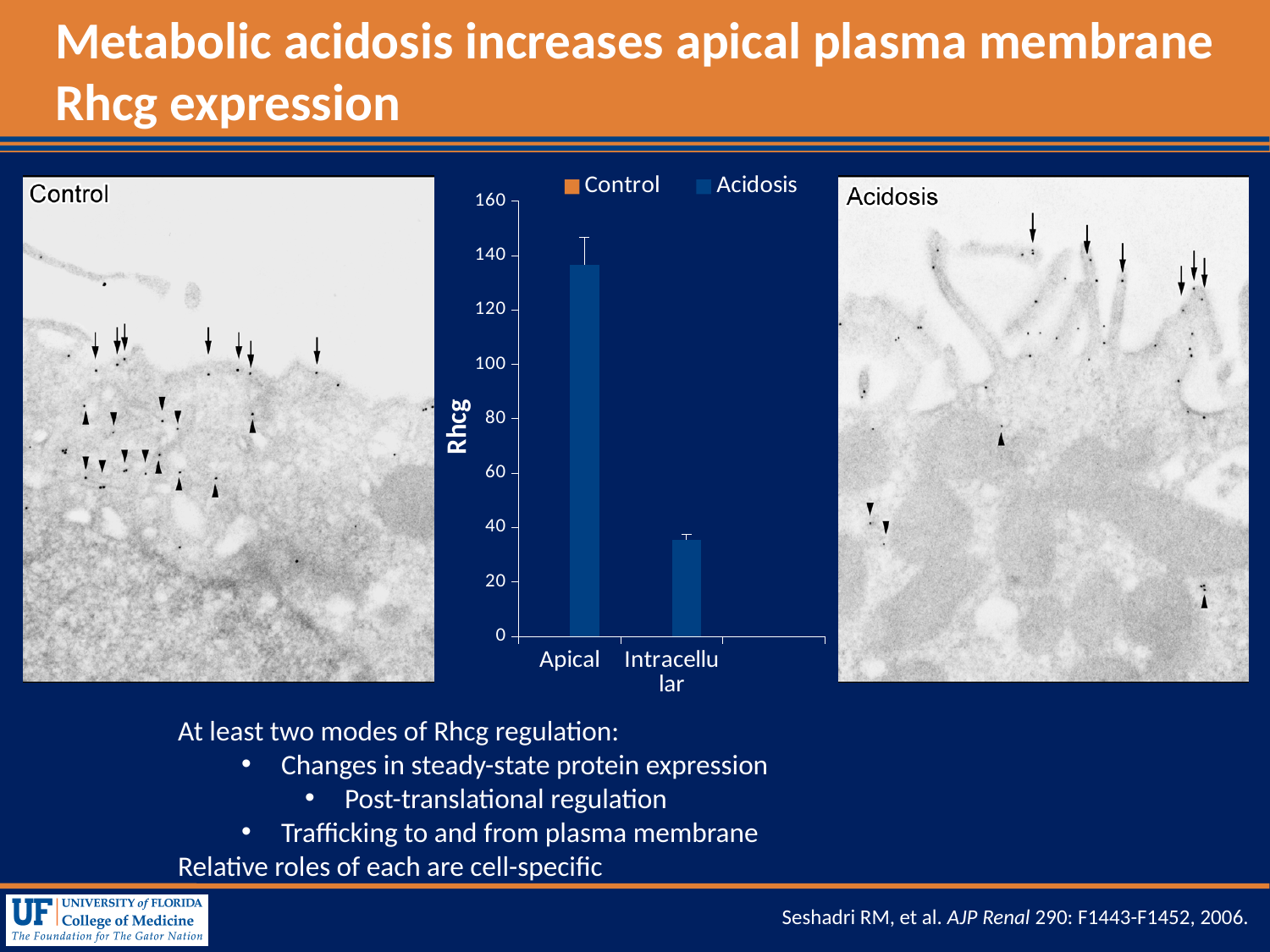
What is the label on the y axis of the bar chart? Rhcg What are the two legend entries of the bar chart? Control and Acidosis In the bar chart, is the Acidosis value for Intracellular greater or less than 40? less In the bar chart, is the Acidosis value for Apical greater or less than 120? greater Which category has the tallest bar in the bar chart? Apical How many categories are shown on the x axis of the bar chart? 2 How many series does the legend of the bar chart list? 2 What kind of chart is shown in the middle of the slide? bar chart Do the bar values rise or fall going from Apical to Intracellular along the x axis? fall Which category has the shortest bar in the bar chart? Intracellular In the bar chart, which is larger: the Acidosis bar for Apical or for Intracellular? Apical